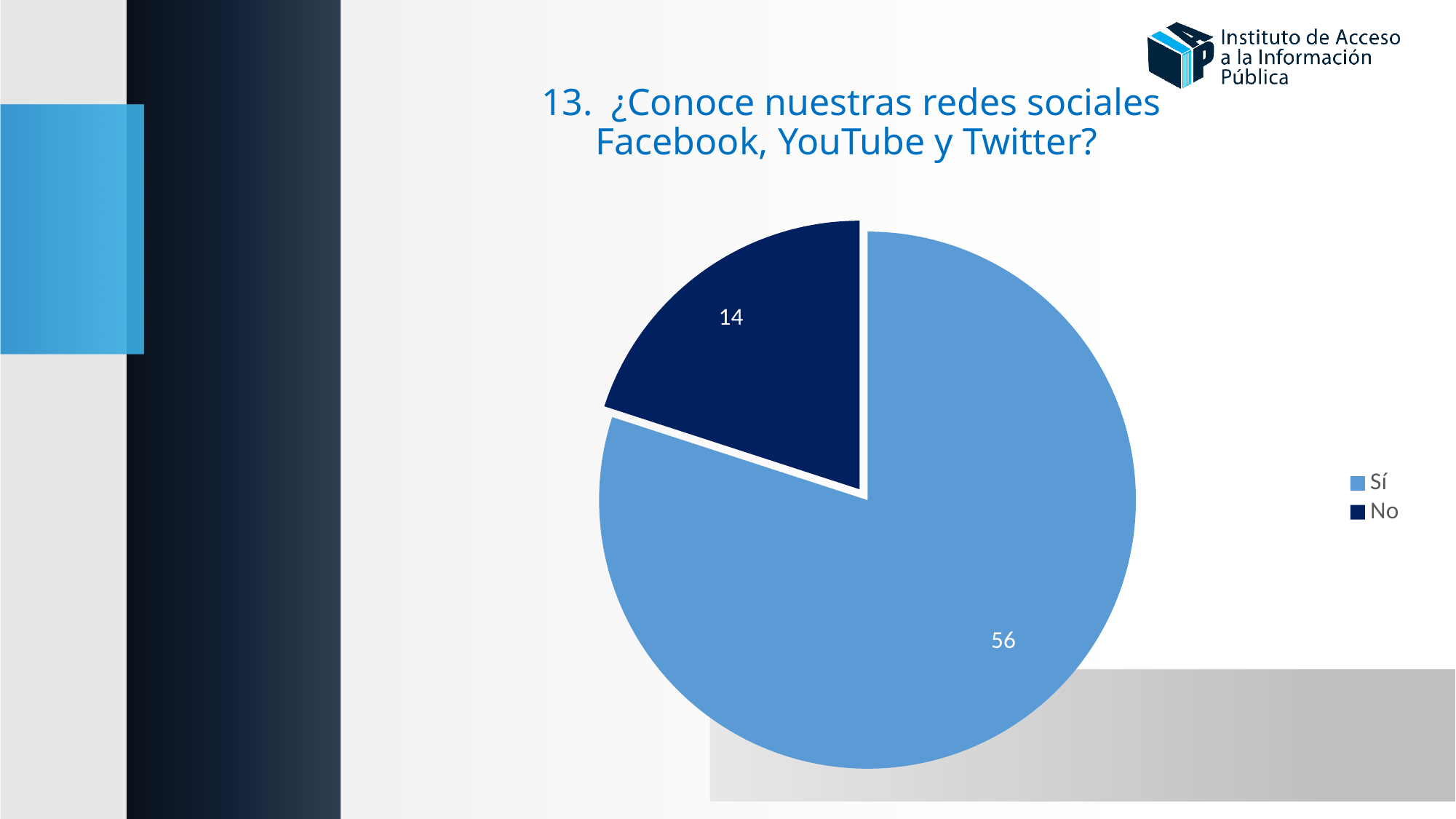
Which category has the largest slice? Sí What is the total of all slices in the pie chart? 70 What is the difference between the values for Sí and No? 42 How many entries does the legend list? 2 What is the value for No? 14 What share of the pie does the No slice represent? 20% What colour is the Sí slice? Light blue What kind of chart is shown on the slide? Pie chart How many slices does the pie chart have? 2 What is the value for Sí? 56 Which category has the smallest slice? No Which is larger, the value for Sí or the value for No? Sí